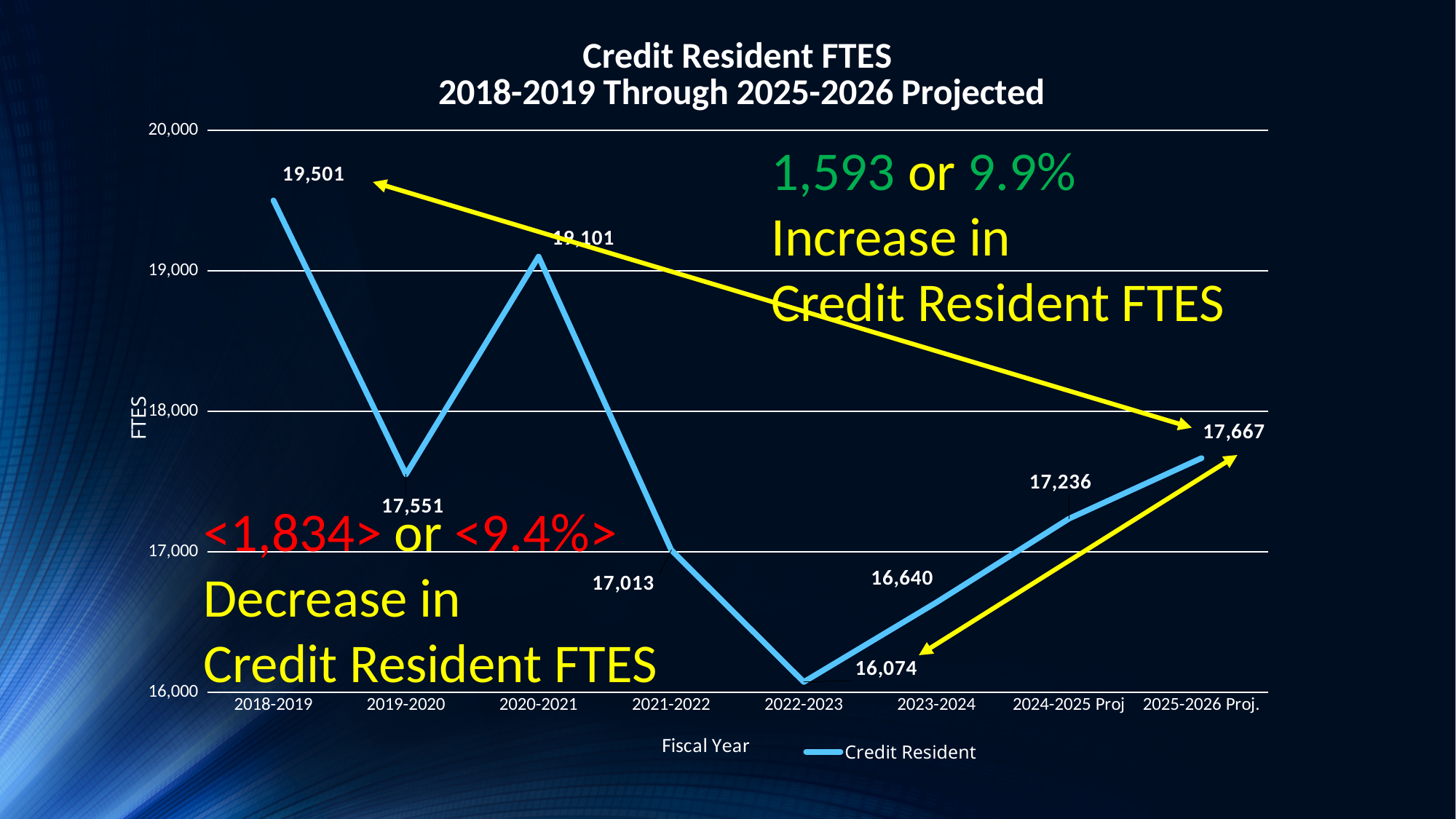
What is the Credit Resident FTES value for 2022-2023? 16,074 What type of chart is shown on the slide? line chart How many series does the legend list? 1 What is the Credit Resident FTES value for 2018-2019? 19,501 Is the Credit Resident FTES value for 2019-2020 greater or less than 18,000? less How many fiscal years are plotted on the x axis? 8 What is the projected Credit Resident FTES value for 2025-2026? 17,667 Which fiscal year has the lowest Credit Resident FTES? 2022-2023 What is the Credit Resident FTES value for 2023-2024? 16,640 What is the difference between the Credit Resident FTES for 2018-2019 and 2019-2020? 1,950 Which fiscal year has the highest Credit Resident FTES? 2018-2019 Which is larger, the Credit Resident FTES for 2021-2022 or for 2024-2025 Proj? 2024-2025 Proj